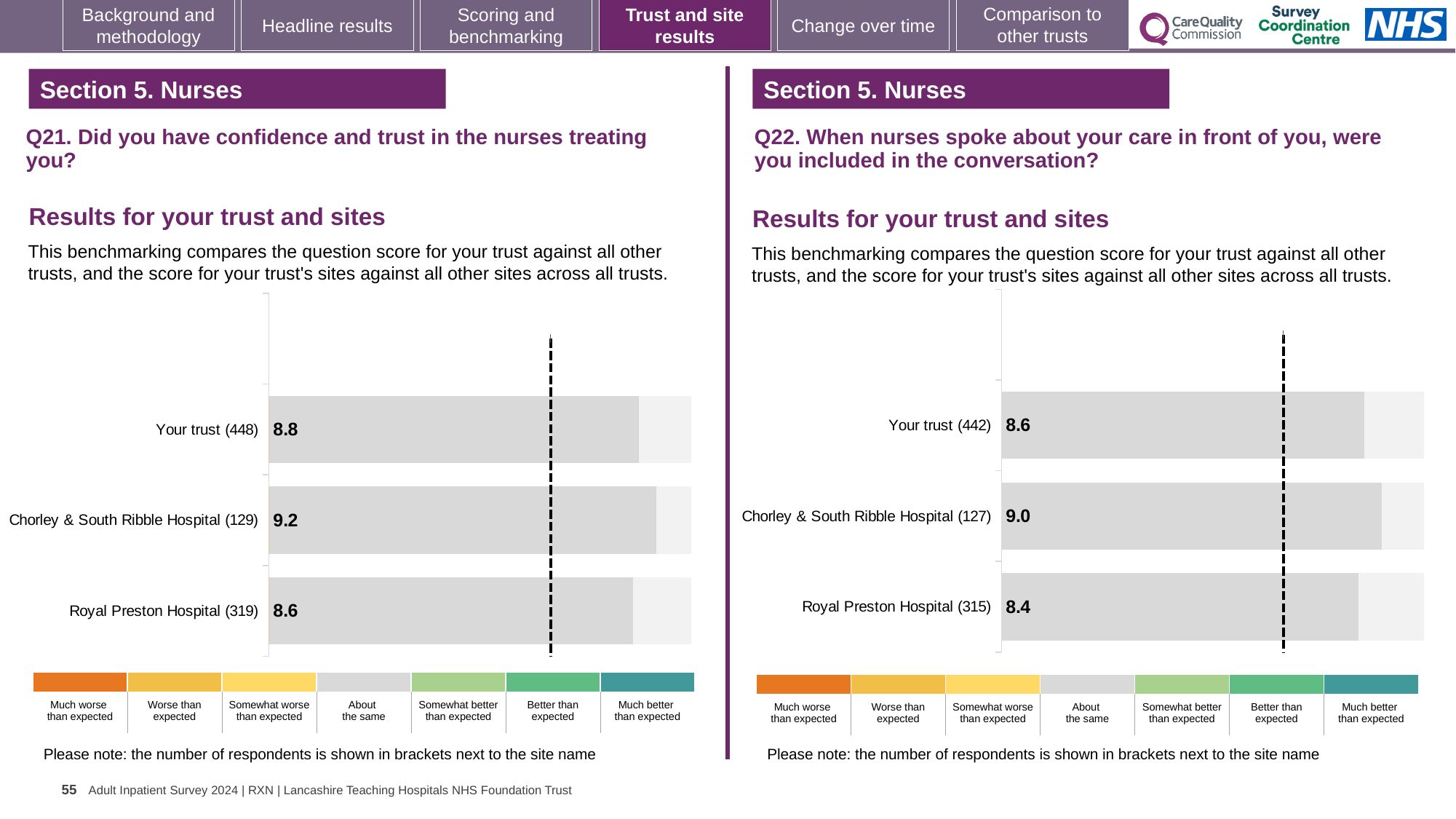
In the Q22 chart on the right, which site or trust has the highest score? Chorley & South Ribble Hospital In the Q21 chart on the left, what is the score for Chorley & South Ribble Hospital? 9.2 What type of chart is used in the Q21 chart on the left? bar chart In the Q21 chart on the left, what is the score for Your trust? 8.8 In the Q21 chart on the left, what is the difference between the scores for Chorley & South Ribble Hospital and Royal Preston Hospital? 0.6 In the Q21 chart on the left, which site or trust has the lowest score? Royal Preston Hospital In the Q21 chart on the left, how many respondents are shown in brackets for Royal Preston Hospital? 319 In the Q22 chart on the right, what is the difference between the scores for Your trust and Royal Preston Hospital? 0.2 In the Q22 chart on the right, how many respondents are shown in brackets for Your trust? 442 In the Q22 chart on the right, is the score for Your trust larger or smaller than the score for Chorley & South Ribble Hospital? smaller In the Q22 chart on the right, what is the score for Royal Preston Hospital? 8.4 How many bars are plotted in the Q22 chart on the right? 3